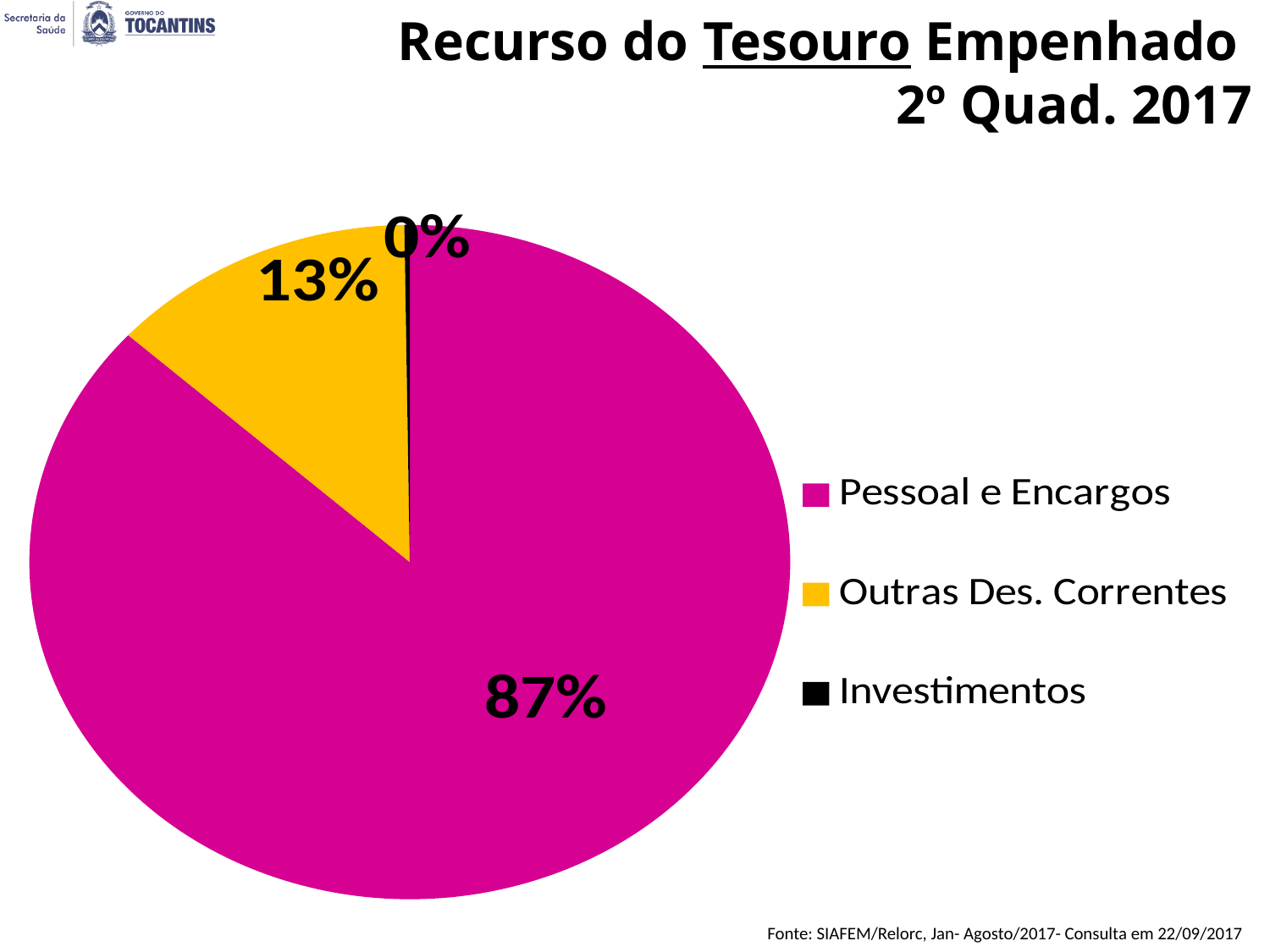
Which category has the largest slice of the pie? Pessoal e Encargos Which is larger, the slice for Outras Des. Correntes or the slice for Investimentos? Outras Des. Correntes What share of the pie does Investimentos represent? 0% What share of the pie does Pessoal e Encargos represent? 87% What is the title of the chart? Recurso do Tesouro Empenhado 2º Quad. 2017 Which category has the smallest slice of the pie? Investimentos What kind of chart is shown on the slide? pie chart What colour is the slice for Outras Des. Correntes? yellow What is the difference in percentage points between Pessoal e Encargos and Outras Des. Correntes? 74 What share of the pie does Outras Des. Correntes represent? 13% How many categories does the legend list? 3